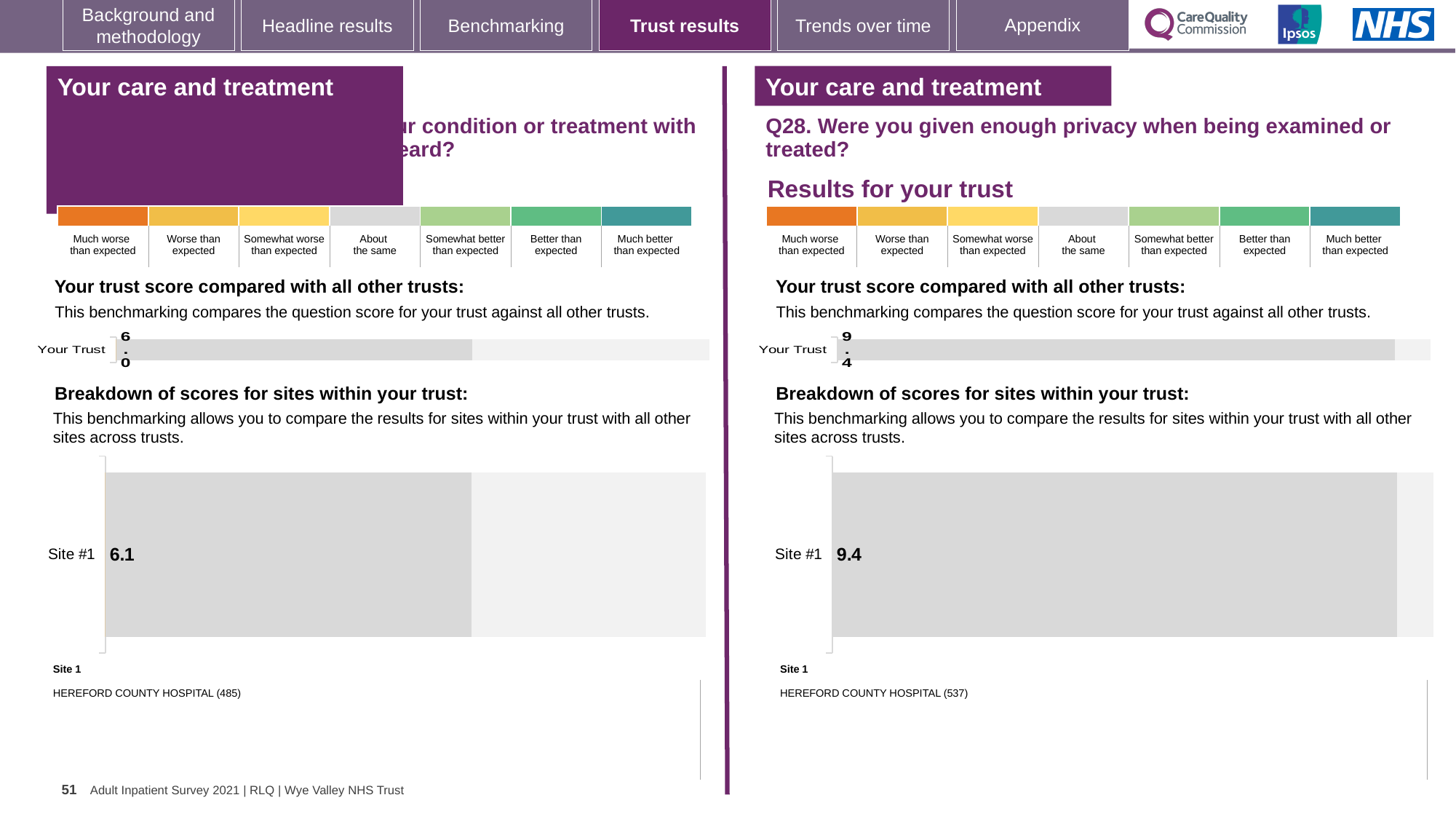
On the right-hand chart for Q28, what is the score shown for Site #1? 9.4 On the left-hand chart (the first question on the slide), what is the score shown for Your Trust? 6.0 On the left-hand chart (the first question on the slide), what is the score shown for Site #1? 6.1 On the right-hand chart for Q28 (privacy when being examined or treated), what is the score shown for Your Trust? 9.4 On the left-hand chart, is the Site #1 score greater or less than the Your Trust score? greater What type of chart is used to show the Site #1 score on the right-hand Q28 chart? Bar chart On the left-hand chart, which site is listed as Site 1? HEREFORD COUNTY HOSPITAL (485) Which has the higher Site #1 score: the left-hand chart or the right-hand Q28 chart? The right-hand Q28 chart What is the difference between the Site #1 score on the right-hand Q28 chart and the Site #1 score on the left-hand chart? 3.3 On the right-hand Q28 chart, which site is listed as Site 1? HEREFORD COUNTY HOSPITAL (537) How many sites are shown in the breakdown of scores on the right-hand Q28 chart? 1 What is the difference between the Your Trust score on the right-hand Q28 chart and the Your Trust score on the left-hand chart? 3.4